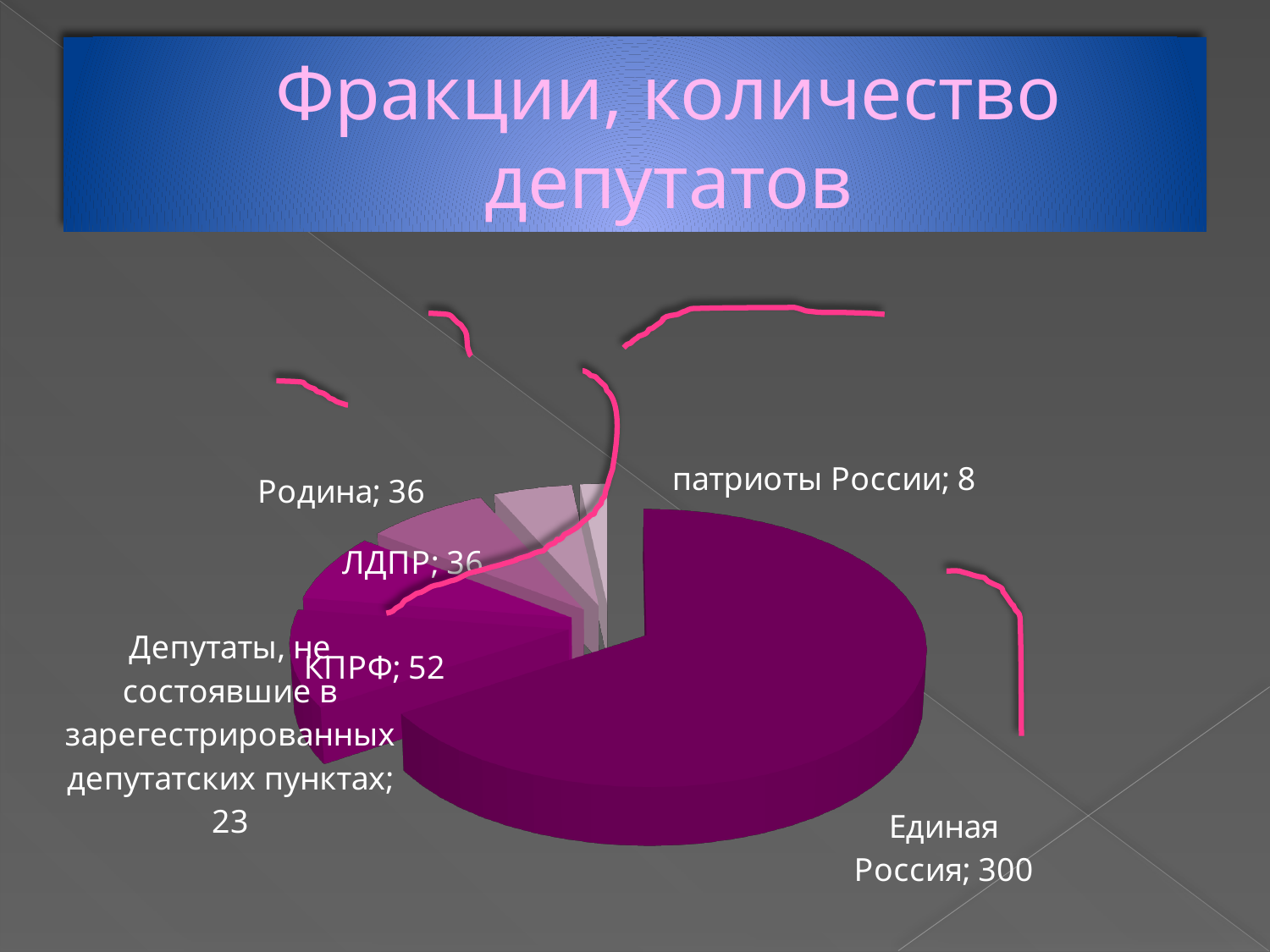
What is the title of the chart on the slide? Фракции, количество депутатов What is the difference between the values for Единая Россия and КПРФ? 248 Which faction has the smallest slice of the pie? патриоты России What is the value shown for патриоты России? 8 What is the value shown for Родина? 36 How many slices does the pie chart have? 6 Which faction has the largest slice of the pie? Единая Россия What is the value shown for КПРФ? 52 What is the difference between the values for ЛДПР and патриоты России? 28 Which is larger, the value for КПРФ or the value for ЛДПР? КПРФ What kind of chart is shown on the slide? Pie chart How many deputies does the chart show for Единая Россия? 300